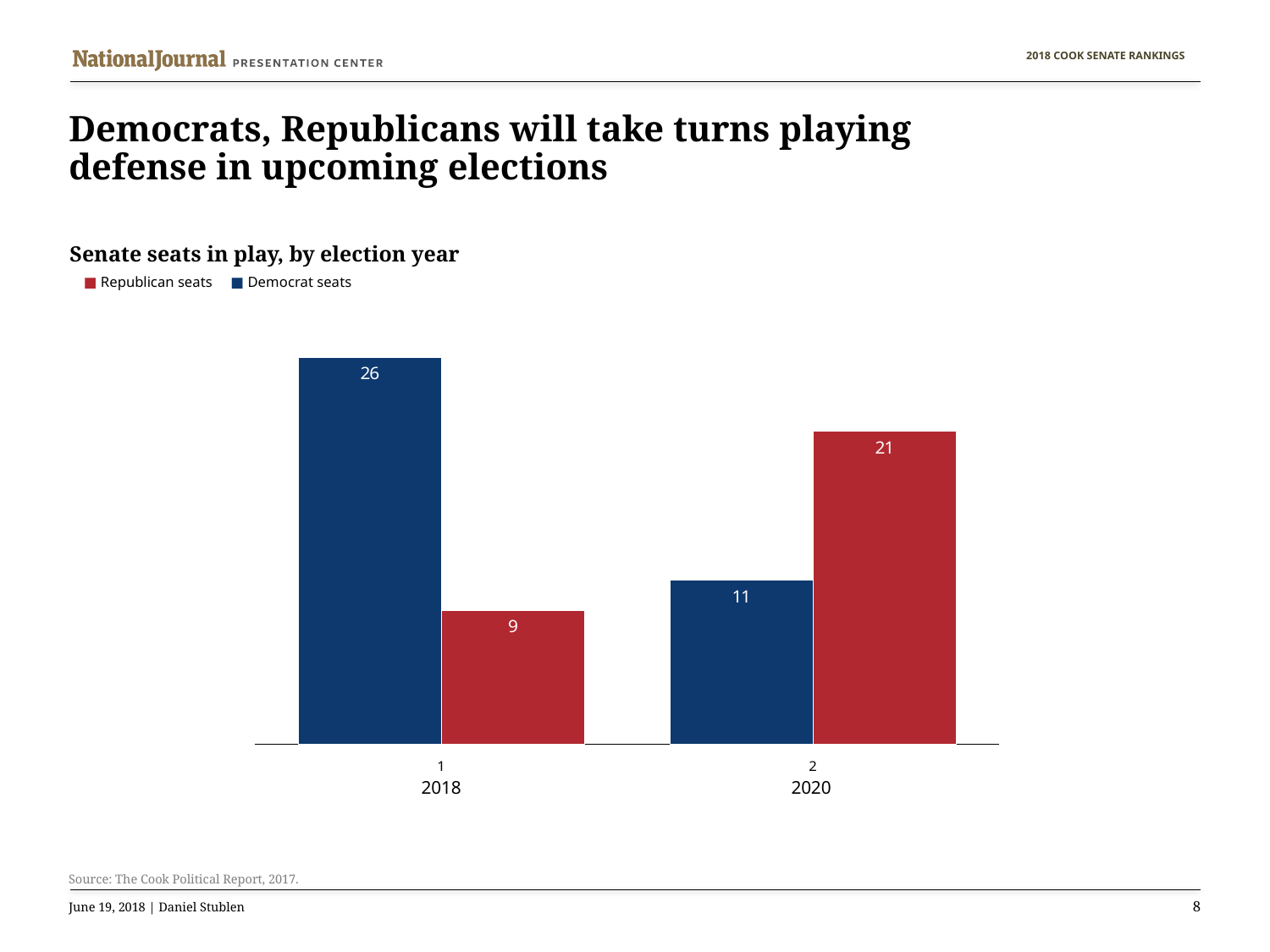
What is the difference between Democrat seats and Republican seats in play in 2018? 17 How many Democrat seats are in play in 2020? 11 How many Republican seats are in play in 2020? 21 What type of chart is shown on the slide? Bar chart Which election year has the fewest Republican seats in play? 2018 How many series does the legend list? 2 What is the difference between Republican seats and Democrat seats in play in 2020? 10 How many Democrat seats are in play in 2018? 26 Which election year has the most Democrat seats in play? 2018 How many election years are shown on the chart? 2 In 2020, are more Republican seats or Democrat seats in play? Republican seats How many Republican seats are in play in 2018? 9